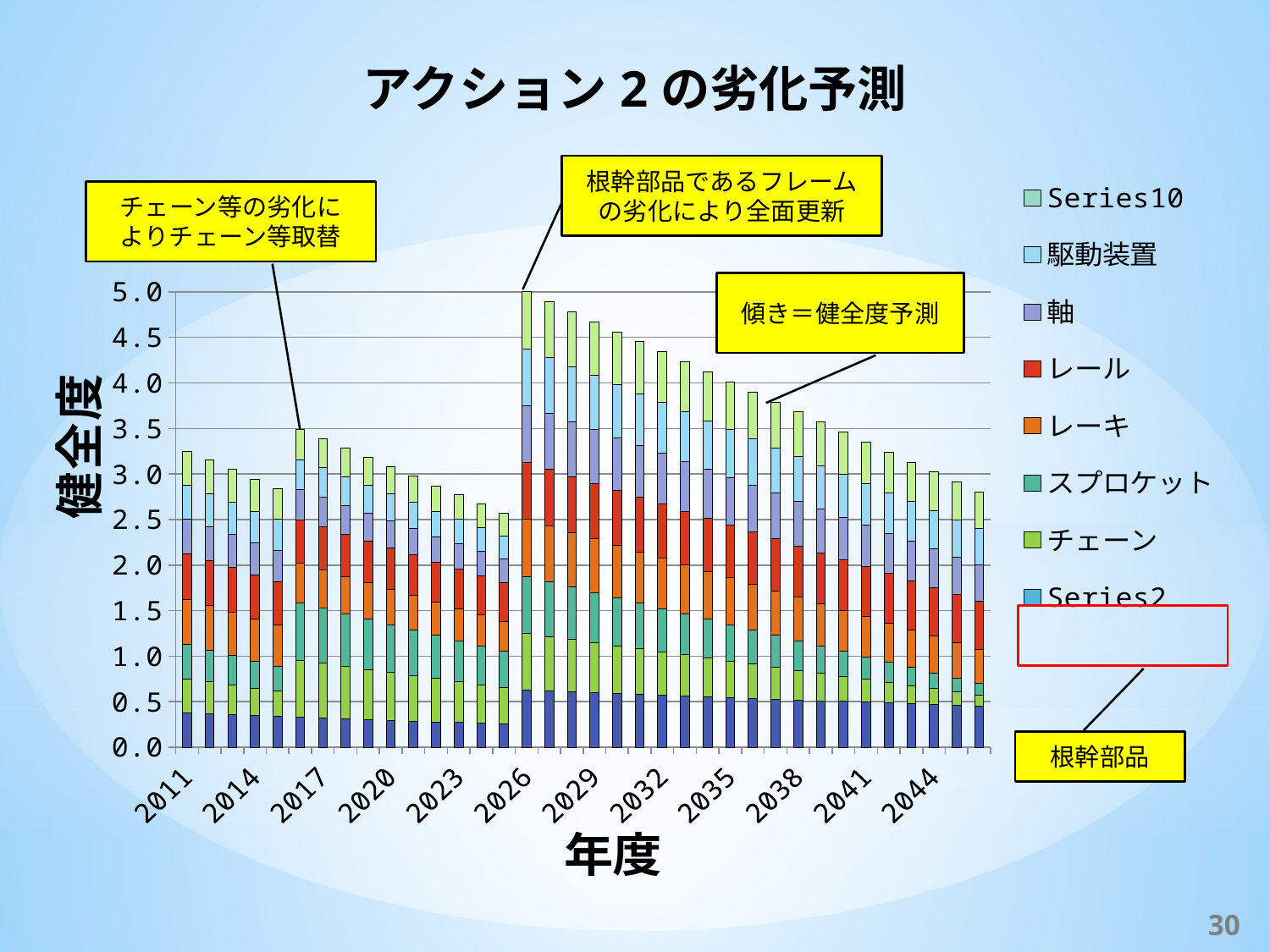
Is the total value of the bar for 2026 greater or less than 4.5? greater Is the total value of the bar for 2038 greater or less than 4.0? less Is the total value of the bar for 2011 greater or less than 3.0? greater How many series does the visible legend list? 8 What kind of chart is shown on the slide? stacked bar chart What is the label of the vertical axis? 健全度 From 2026 onward, do the total bar values rise or fall along the x axis? fall Which bar is taller, the one for 2011 or the one for 2026? 2026 Which year has the tallest stacked bar? 2026 What is the title of the chart? アクション２の劣化予測